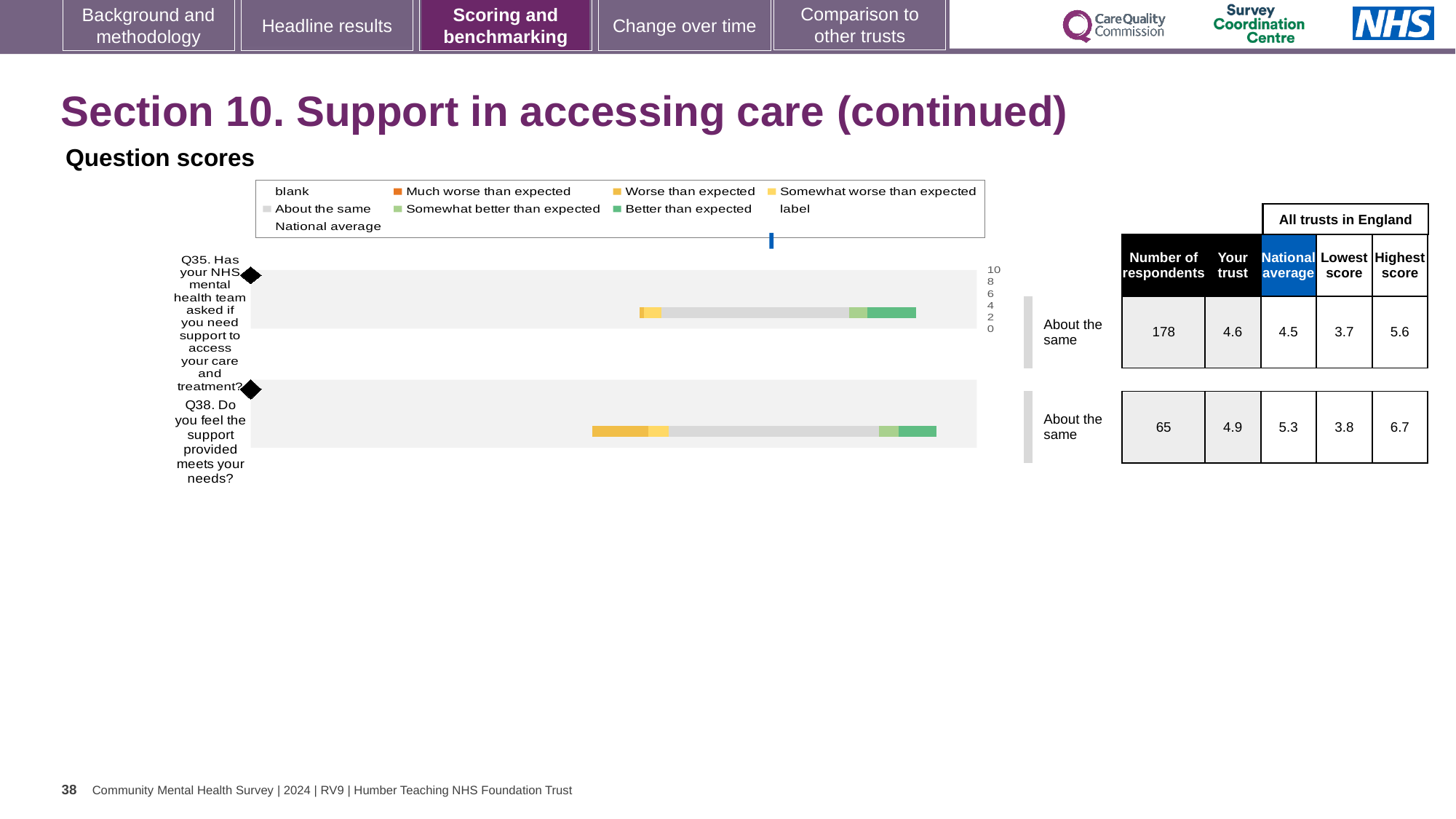
For Q38, which is higher: the 'Your trust' score or the national average? National average What benchmark category is shown for Q35 and Q38? About the same What is the difference between the highest and lowest scores for Q38? 2.9 How many questions are plotted in the question scores chart? 2 How many respondents answered Q35? 178 What is the 'Your trust' score for Q35 (Has your NHS mental health team asked if you need support to access your care and treatment?)? 4.6 What is the national average score for Q38 (Do you feel the support provided meets your needs?)? 5.3 For Q35, which is higher: the 'Your trust' score or the national average? Your trust What is the lowest score across all trusts in England for Q35? 3.7 What is the highest score across all trusts in England for Q38? 6.7 How many respondents answered Q38? 65 What kind of chart is used to show the question scores on this slide? bar chart